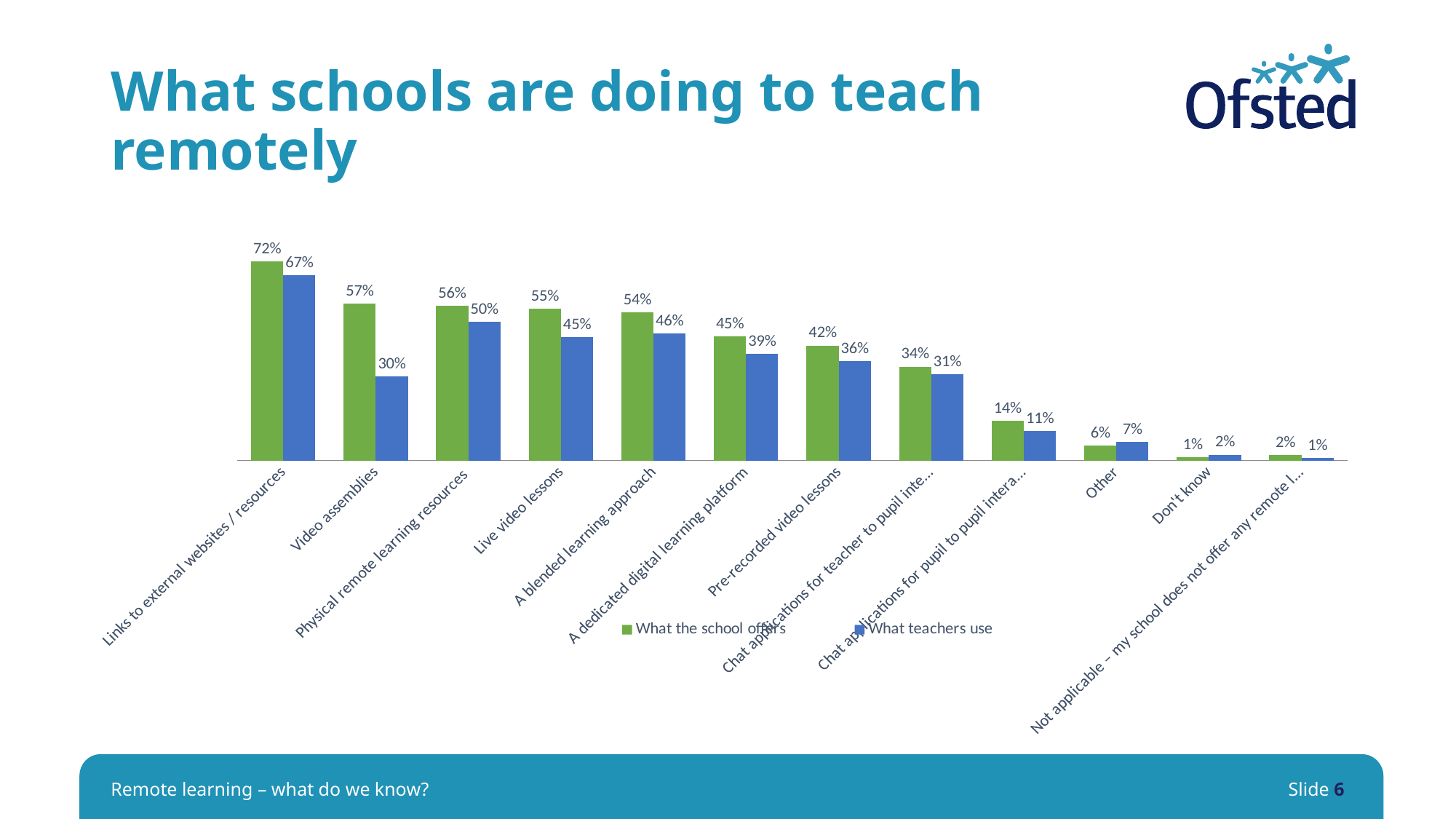
For 'Other', which is larger: 'What the school offers' or 'What teachers use'? What teachers use What percentage of schools offer video assemblies according to the 'What the school offers' series? 57% How many categories are shown on the x axis of the chart? 12 What is the 'What the school offers' value for pre-recorded video lessons? 42% What is the 'What teachers use' value for live video lessons? 45% What kind of chart is shown on the slide? Bar chart What colour represents the 'What teachers use' series? Blue Which category has the highest value in the 'What the school offers' series? Links to external websites / resources How many series does the legend list? 2 Which category has the lowest value in the 'What teachers use' series? Not applicable – my school does not offer any remote l... Do the 'What the school offers' values generally rise or fall from left to right along the x axis? Fall What is the difference between 'What the school offers' and 'What teachers use' for video assemblies? 27 percentage points